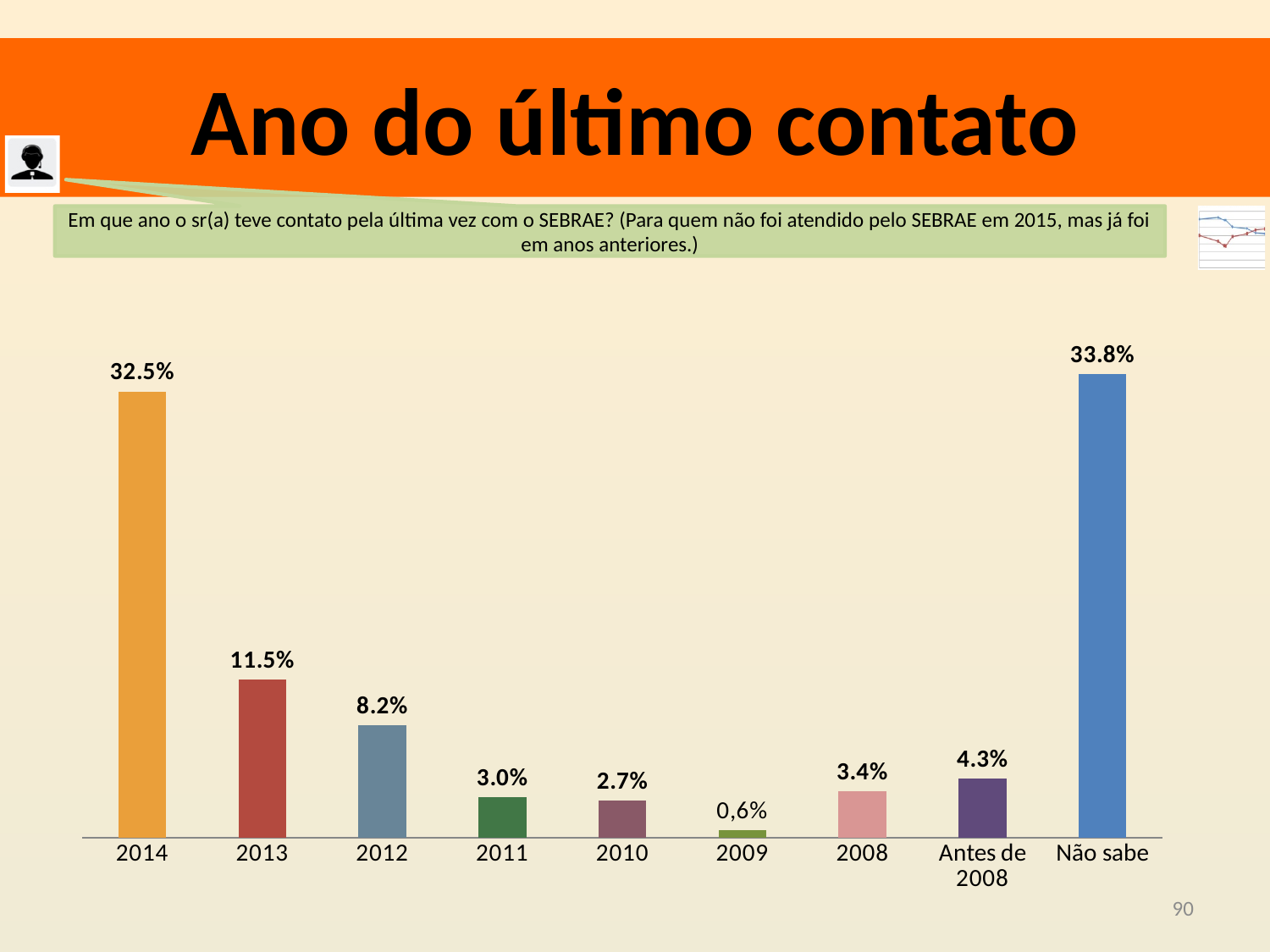
What is the value for "Antes de 2008"? 4.3% Which category has the highest value? Não sabe What kind of chart is shown on the slide? Bar chart How many categories are shown on the x axis? 9 What is the value for "Não sabe"? 33.8% What is the value for 2014? 32.5% What is the difference between the values for 2012 and 2011? 5.2 percentage points What is the value for 2013? 11.5% Which is larger, the value for 2008 or the value for 2010? 2008 Which category has the lowest value? 2009 What is the difference between the values for 2014 and 2013? 21.0 percentage points What is the value for 2009? 0,6%